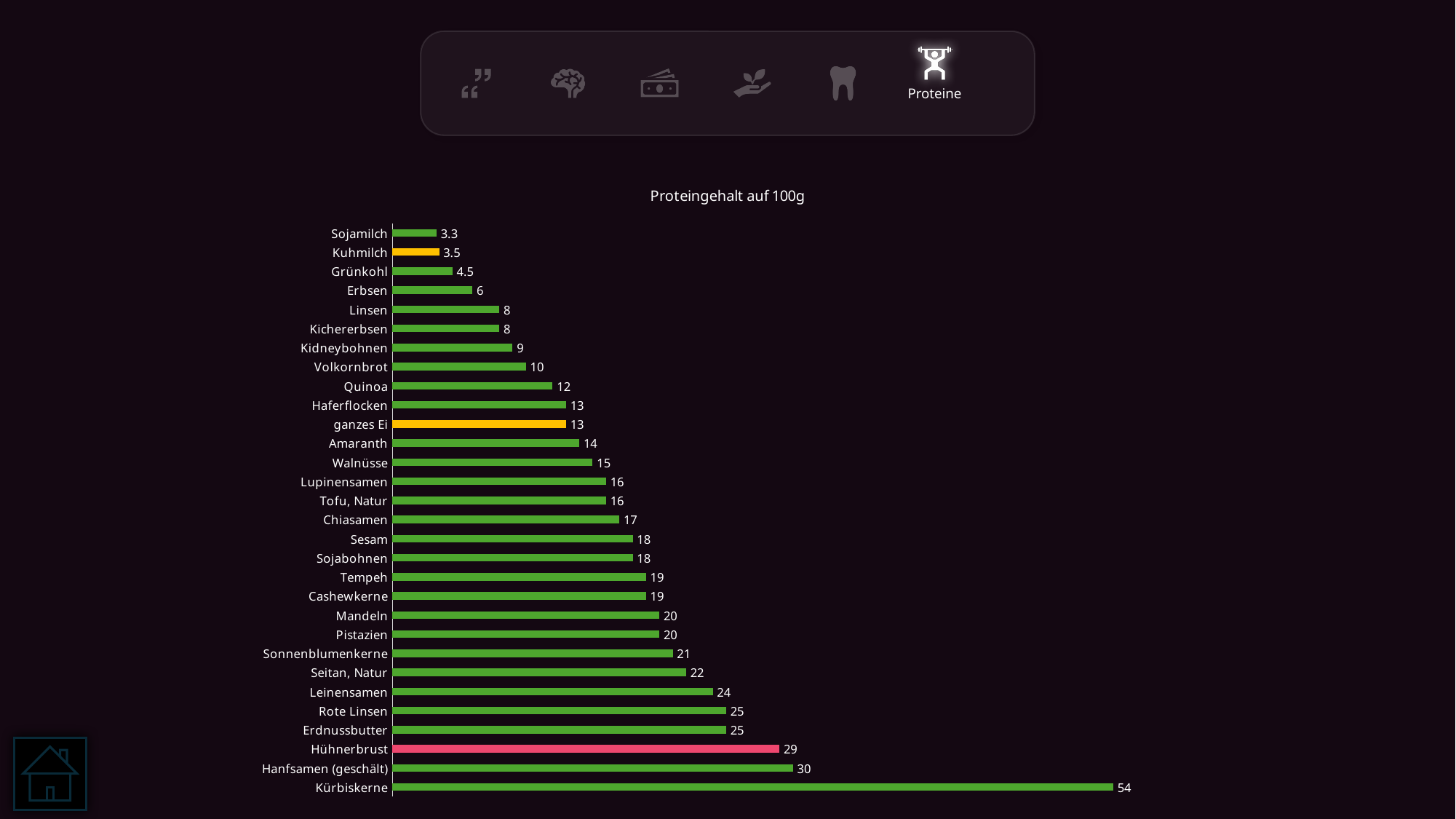
What is the difference between the values for Hühnerbrust and ganzes Ei? 16 Which category has the highest value? Kürbiskerne Which has a larger value, Tempeh or Walnüsse? Tempeh What is the value for Hühnerbrust? 29 Which bar is coloured red/pink rather than green? Hühnerbrust What is the value for Seitan, Natur? 22 What is the value for Kuhmilch? 3.5 What is the title of the chart? Proteingehalt auf 100g What is the difference between the values for Kürbiskerne and Hanfsamen (geschält)? 24 Which category has the lowest value? Sojamilch What type of chart is shown on the slide? bar chart How many categories are shown in the chart? 30